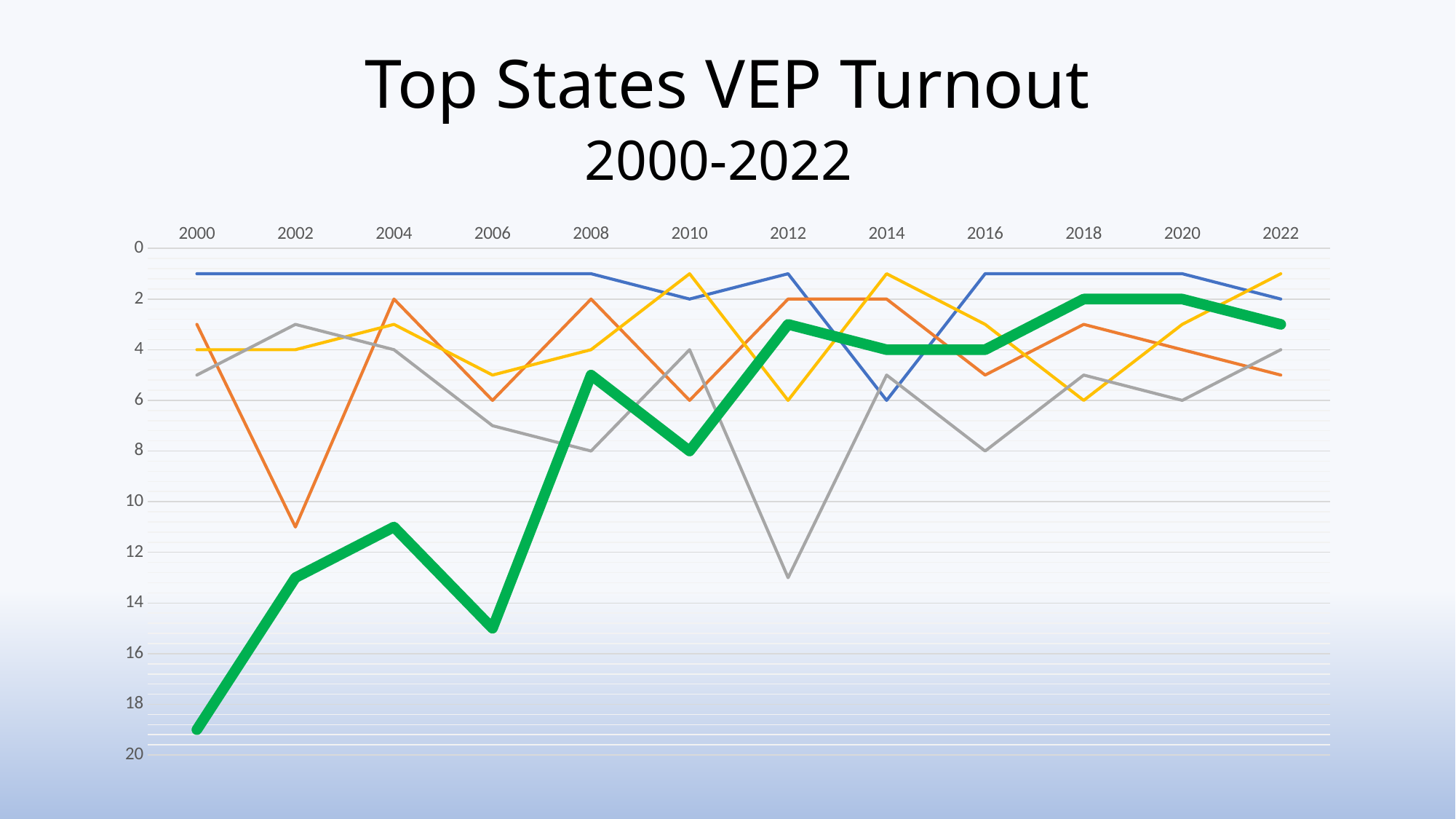
Is the value of the thick green line in 2022 greater or less than 10? less Is the value of the thick green line in 2006 greater or less than 14? greater Do the values on the thick green line rise or fall from 2000 to 2022? fall What is the title of the chart? Top States VEP Turnout 2000-2022 How many lines are plotted on the chart? 5 How many years are shown along the x axis? 12 Is the value of the thick green line in 2000 greater or less than 10? greater What kind of chart is shown on the slide? line chart What is the first year shown on the x axis? 2000